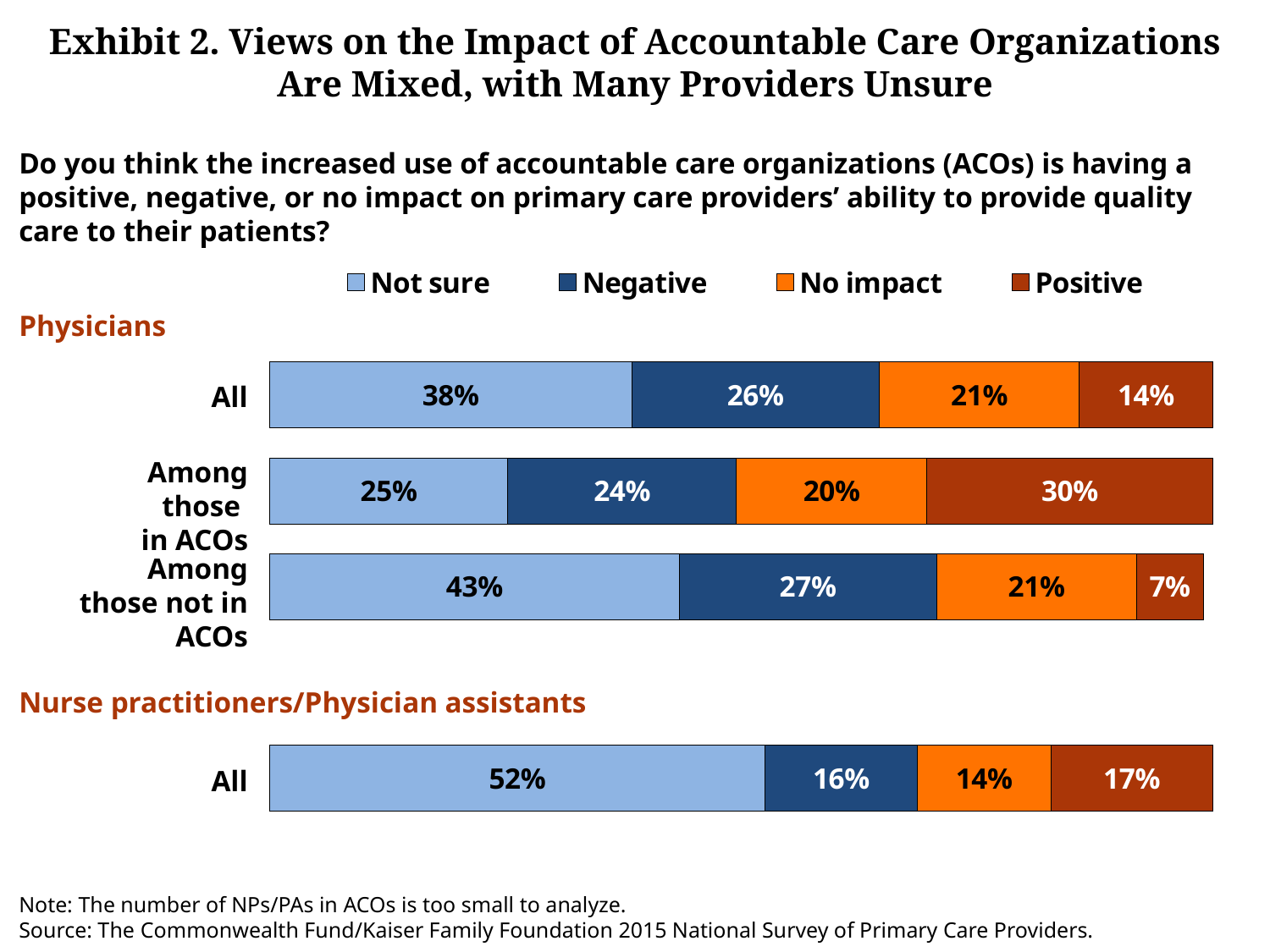
How many response categories does the legend list? 4 Which colour represents the 'No impact' response in the legend? Orange How many bars are shown on the slide? 4 What is the difference in 'Positive' responses between physicians in ACOs and physicians not in ACOs? 23 percentage points What kind of chart is shown on the slide? Stacked bar chart What percentage of physicians not in ACOs said ACOs are having a positive impact? 7% Is the 'Negative' share larger for all physicians or for all nurse practitioners/physician assistants? All physicians What percentage of all nurse practitioners/physician assistants said they are not sure? 52% Which group has the highest share of 'Not sure' responses? Nurse practitioners/Physician assistants (All) What percentage of all physicians said they are not sure about the impact of ACOs? 38% What percentage of physicians in ACOs said ACOs are having a positive impact? 30% Which physician group has the lowest share of 'Positive' responses? Among those not in ACOs